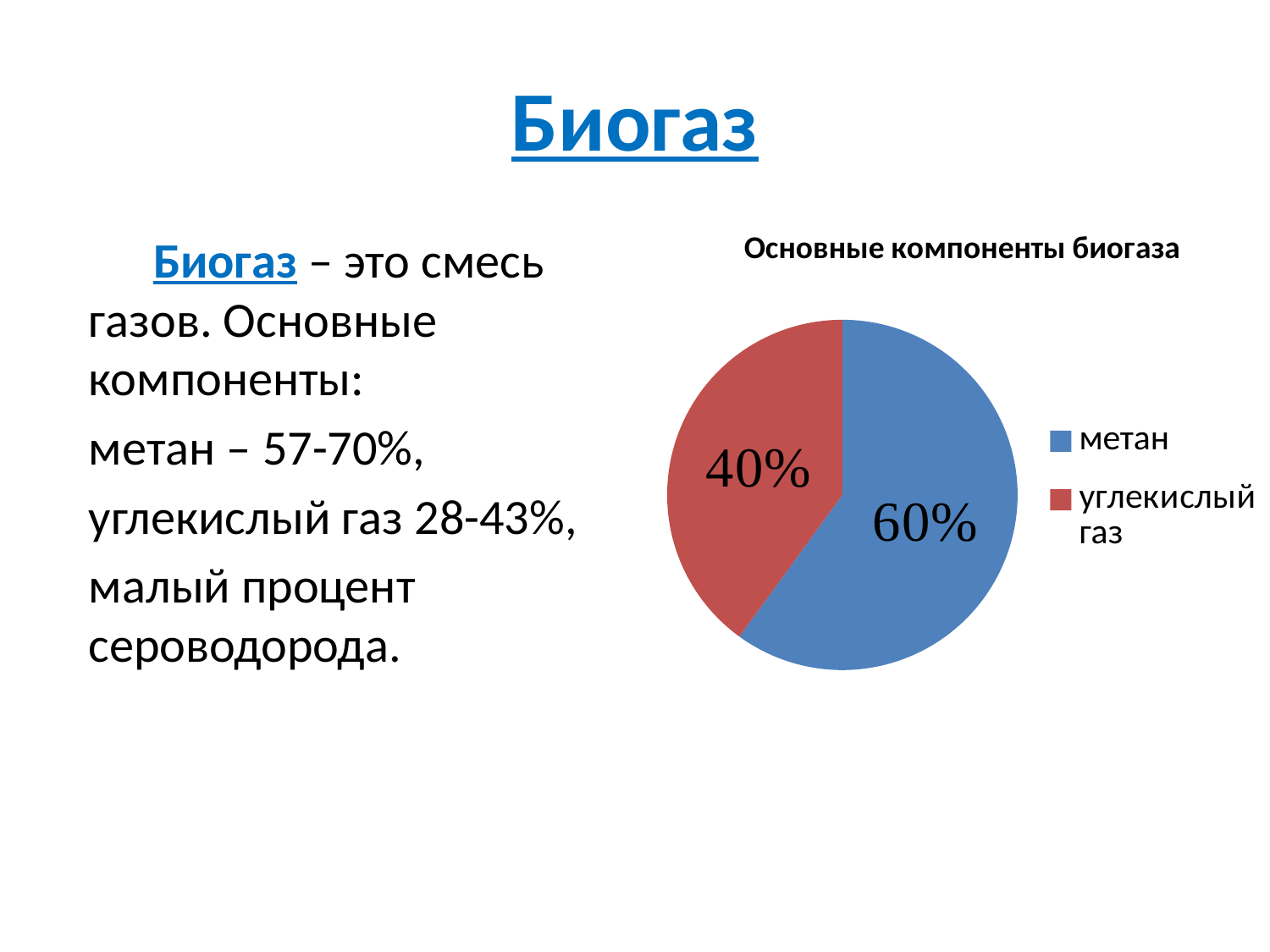
Which is larger: the slice for метан or the slice for углекислый газ? метан What share of the pie does углекислый газ have? 40% What type of chart is shown on the slide? pie chart What share of the pie does метан have? 60% What is the difference in percentage points between the метан slice and the углекислый газ slice? 20 What is the title of the chart? Основные компоненты биогаза How many entries does the legend list? 2 What colour is the slice for метан? blue How many slices does the pie chart have? 2 Which component has the largest slice of the pie? метан Which component has the smallest slice of the pie? углекислый газ